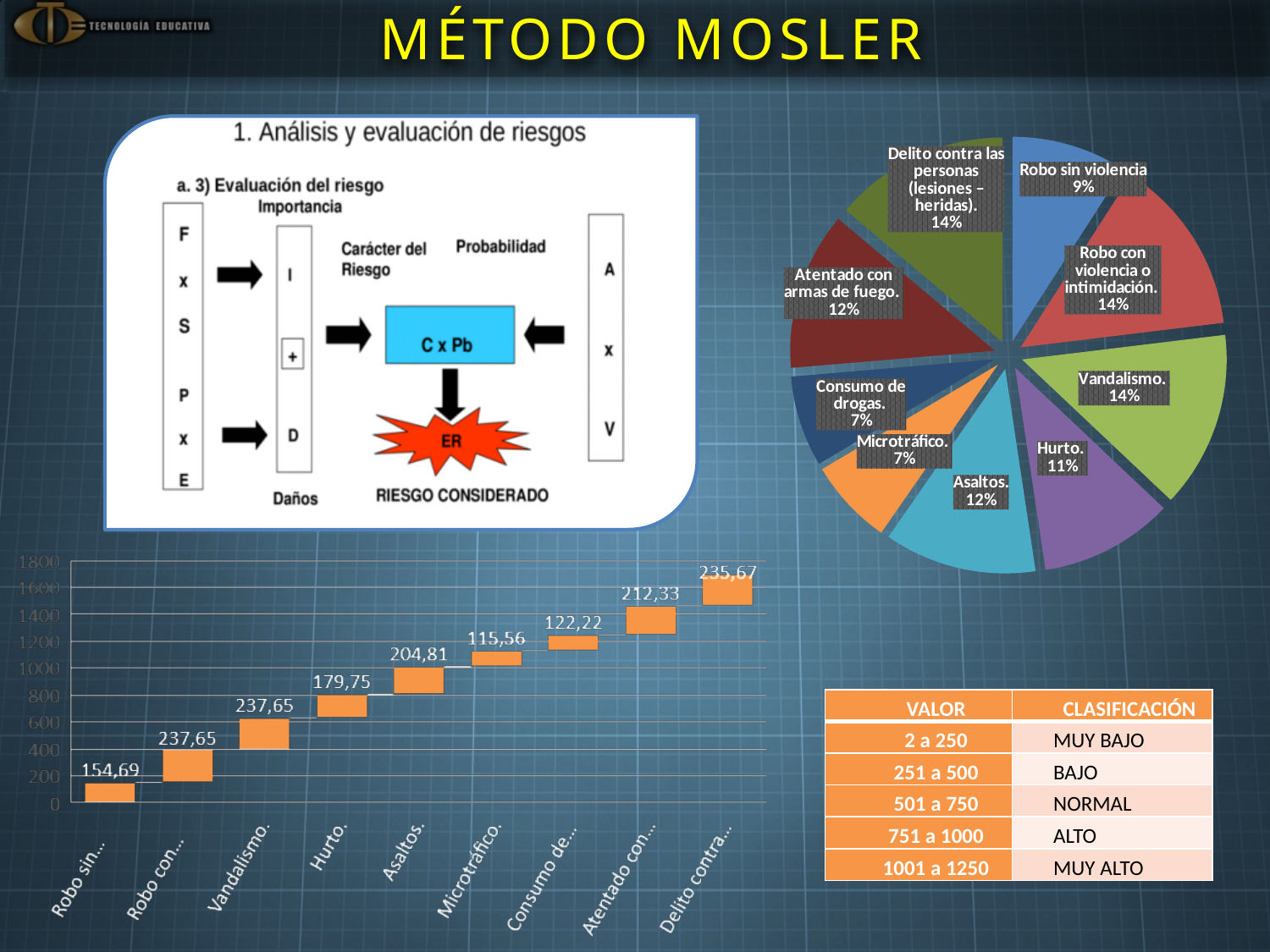
In the bar chart at the bottom left, which has the larger value, Vandalismo or Microtráfico? Vandalismo In the pie chart, what share does Hurto have? 11% In the bar chart at the bottom left, which category has the lowest value? Microtráfico In the bar chart at the bottom left, what is the value for Microtráfico? 115,56 In the pie chart, which slice is larger, Asaltos or Hurto? Asaltos In the bar chart at the bottom left, what is the value for Asaltos? 204,81 How many categories are shown on the x axis of the bar chart at the bottom left? 9 How many slices does the pie chart have? 9 In the bar chart at the bottom left, what is the difference between the values for Asaltos and Hurto? 25,06 What kind of chart is the chart in the top right of the slide? Pie chart In the pie chart, what share does Robo sin violencia have? 9% In the bar chart at the bottom left, what is the value for Hurto? 179,75